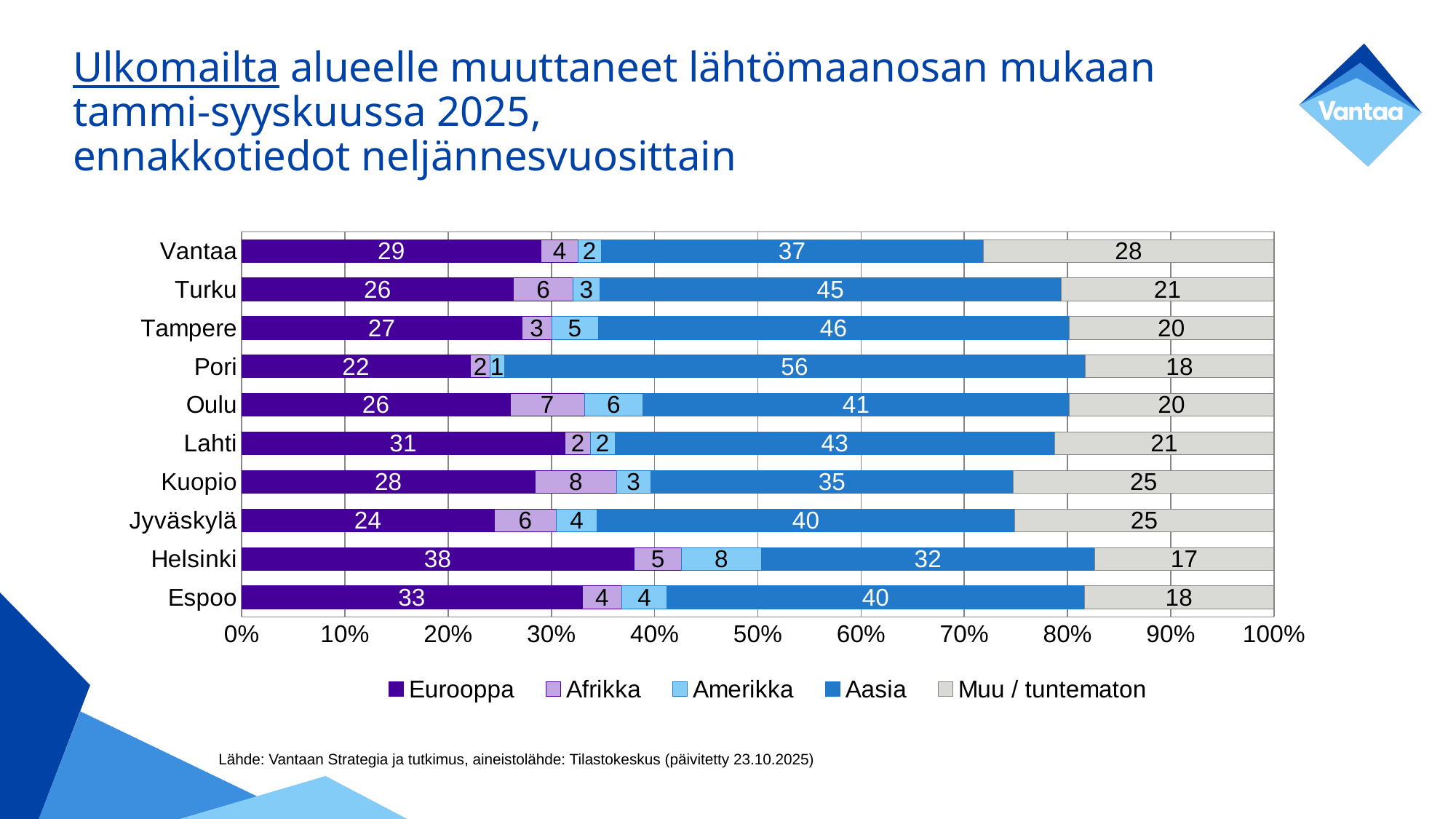
How many series does the legend list? 5 What is the Afrikka value for Kuopio? 8 Which is larger, the Eurooppa value for Espoo or for Lahti? Espoo What is the total of the stacked bar for Vantaa? 100 What is the difference between the Aasia values for Pori and Helsinki? 24 Which city has the highest Aasia value? Pori What is the Eurooppa value for Helsinki? 38 What kind of chart is shown on the slide? Stacked bar chart How many cities are shown on the chart? 10 What is the Aasia value for Vantaa? 37 Which city has the lowest Muu / tuntematon value? Helsinki Which series is shown in grey in the legend? Muu / tuntematon